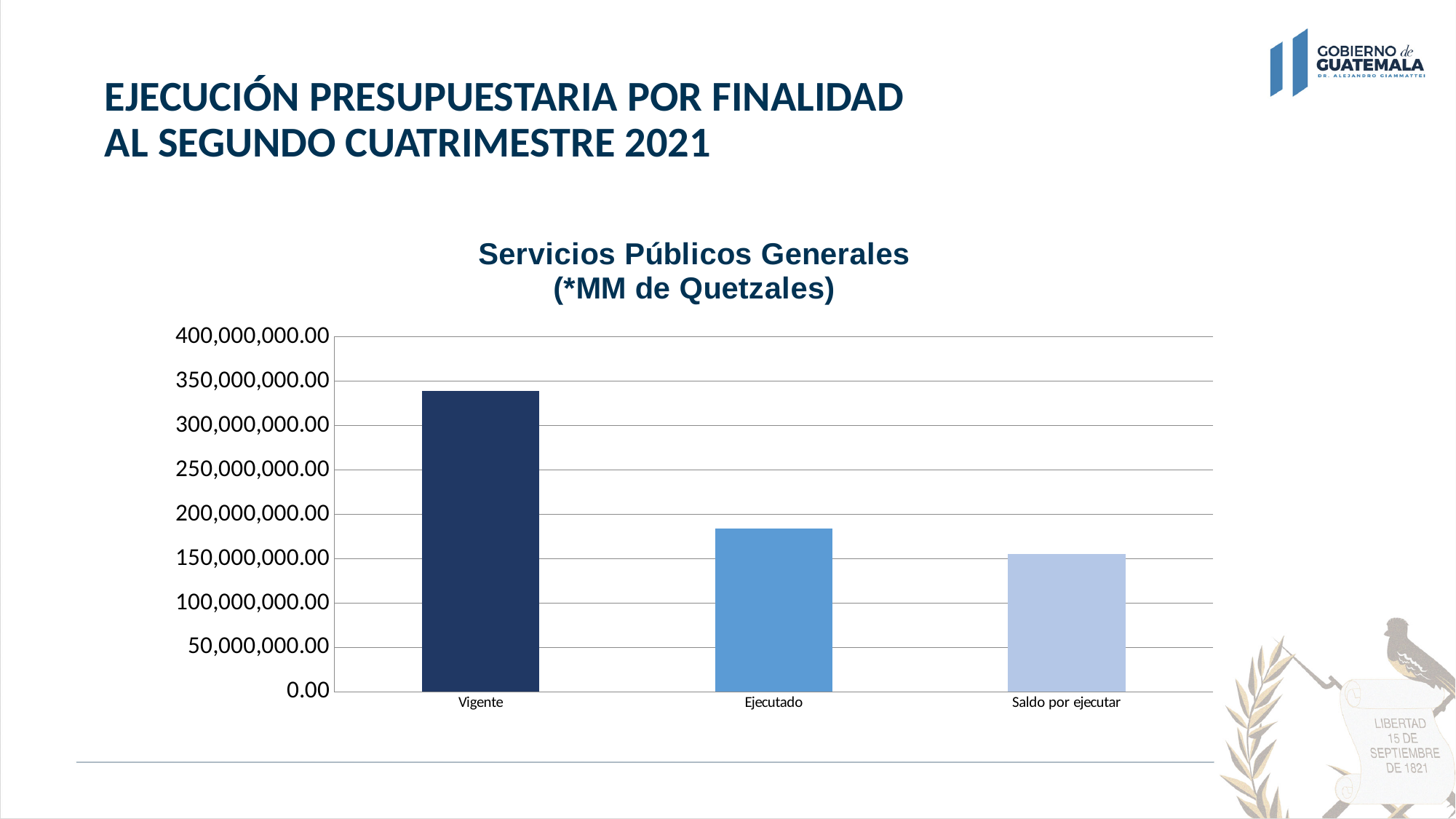
What is the title of the chart? Servicios Públicos Generales (*MM de Quetzales) Do the values rise or fall from left to right across the categories? fall How many categories are plotted in the chart? 3 What is the highest value shown on the vertical axis? 400,000,000.00 Is the value for Saldo por ejecutar greater or less than 200,000,000.00? less Which category has the highest value? Vigente Which is larger, the value for Ejecutado or the value for Saldo por ejecutar? Ejecutado What kind of chart is shown on the slide? bar chart Is the value for Ejecutado greater or less than 150,000,000.00? greater Is the value for Ejecutado greater or less than 200,000,000.00? less Which category has the lowest value? Saldo por ejecutar